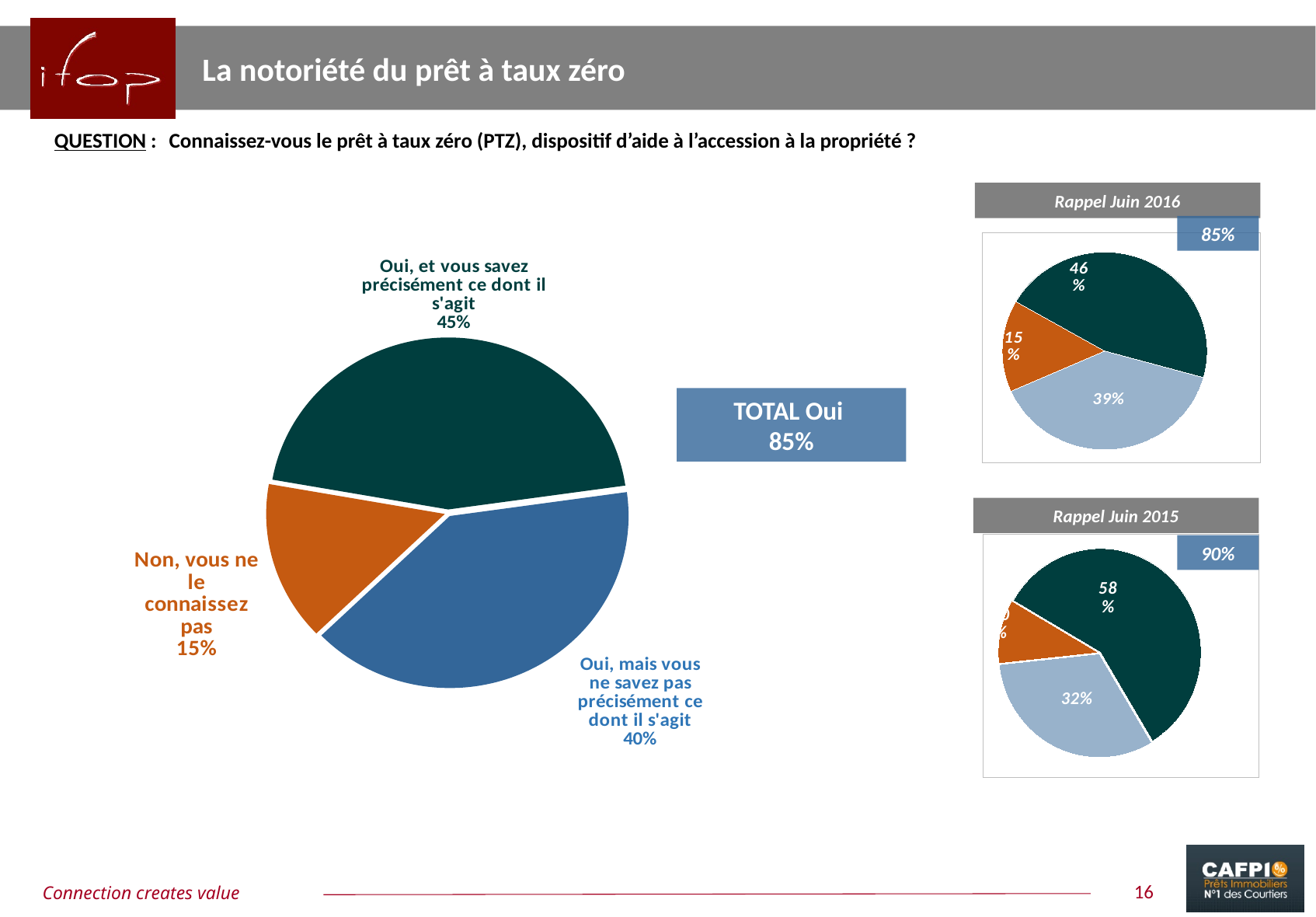
How many slices does the large pie chart on the left have? 3 In the large pie chart on the left, what is the difference in percentage points between "Oui, et vous savez précisément ce dont il s'agit" and "Non, vous ne le connaissez pas"? 30 percentage points In the large pie chart on the left, what percentage is shown for "Non, vous ne le connaissez pas"? 15% What total is shown in the blue box next to the "Rappel Juin 2015" chart? 90% In the large pie chart on the left, which category has the largest slice? Oui, et vous savez précisément ce dont il s'agit Which chart shows a larger value for its dark green slice, "Rappel Juin 2016" or "Rappel Juin 2015"? Rappel Juin 2015 In the large pie chart on the left, what percentage is shown for "Oui, et vous savez précisément ce dont il s'agit"? 45% What kind of chart is the large chart on the left of the slide? Pie chart In the large pie chart on the left, what percentage is shown for "Oui, mais vous ne savez pas précisément ce dont il s'agit"? 40% In the "Rappel Juin 2015" chart, what percentage is shown on the dark green slice? 58% In the "Rappel Juin 2016" chart, what percentage is shown on the light blue slice? 39% In the large pie chart on the left, which category has the smallest slice? Non, vous ne le connaissez pas